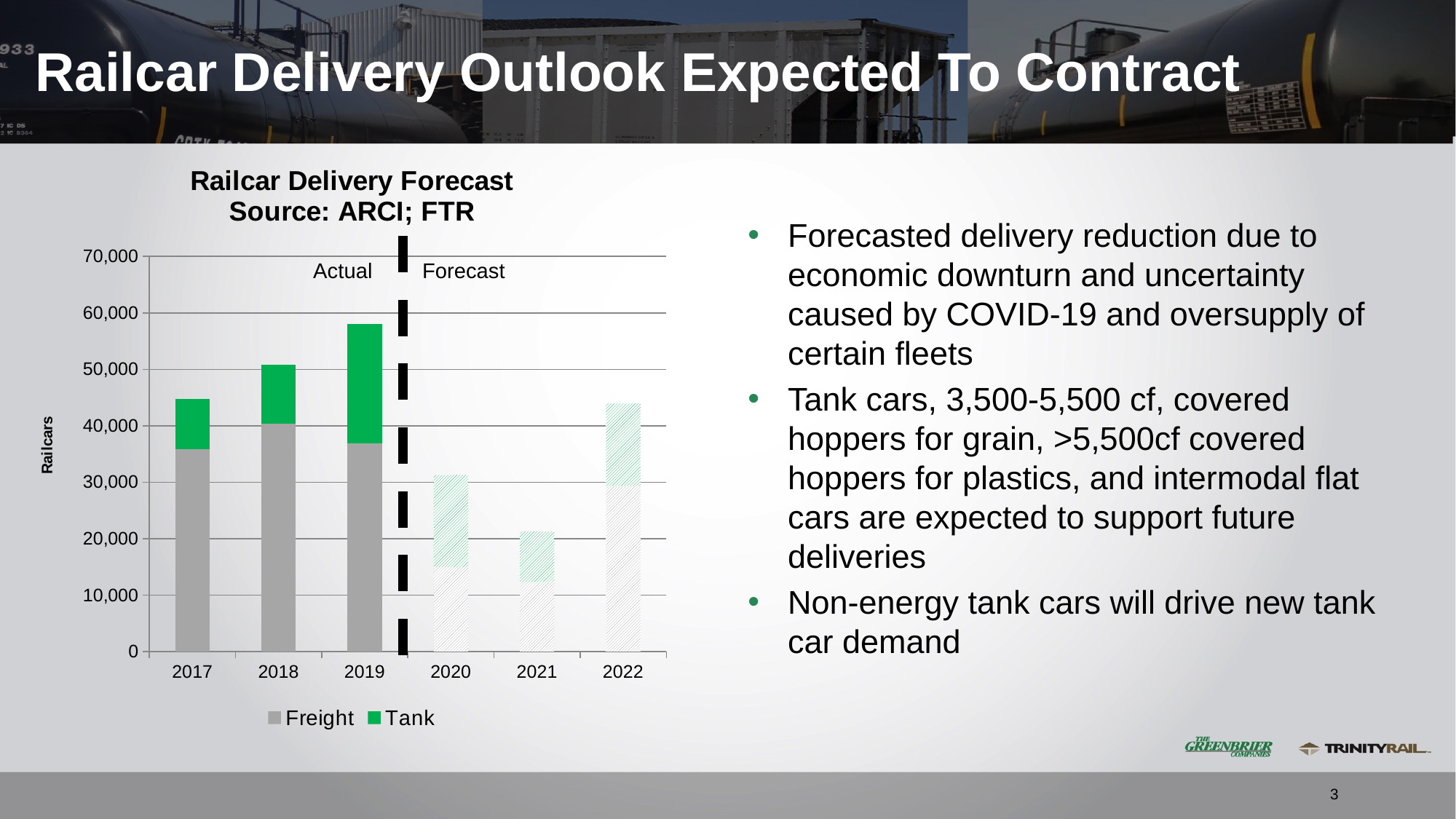
Which year has the highest total railcar deliveries in the Railcar Delivery Forecast chart? 2019 Which year has the larger total deliveries, 2018 or 2020? 2018 How many series does the legend of the Railcar Delivery Forecast chart list? 2 Is the total value for 2019 greater or less than 50,000? greater Which years in the Railcar Delivery Forecast chart fall in the section labeled Forecast? 2020, 2021 and 2022 Is the Freight value for 2017 greater or less than 30,000? greater Do total railcar deliveries rise or fall from 2017 to 2019? rise How many years are shown on the x axis of the Railcar Delivery Forecast chart? 6 What kind of chart is the Railcar Delivery Forecast chart? Stacked bar chart What are the two series named in the legend of the Railcar Delivery Forecast chart? Freight and Tank Which year has the lowest total railcar deliveries in the Railcar Delivery Forecast chart? 2021 Is the total value for 2021 greater or less than 30,000? less